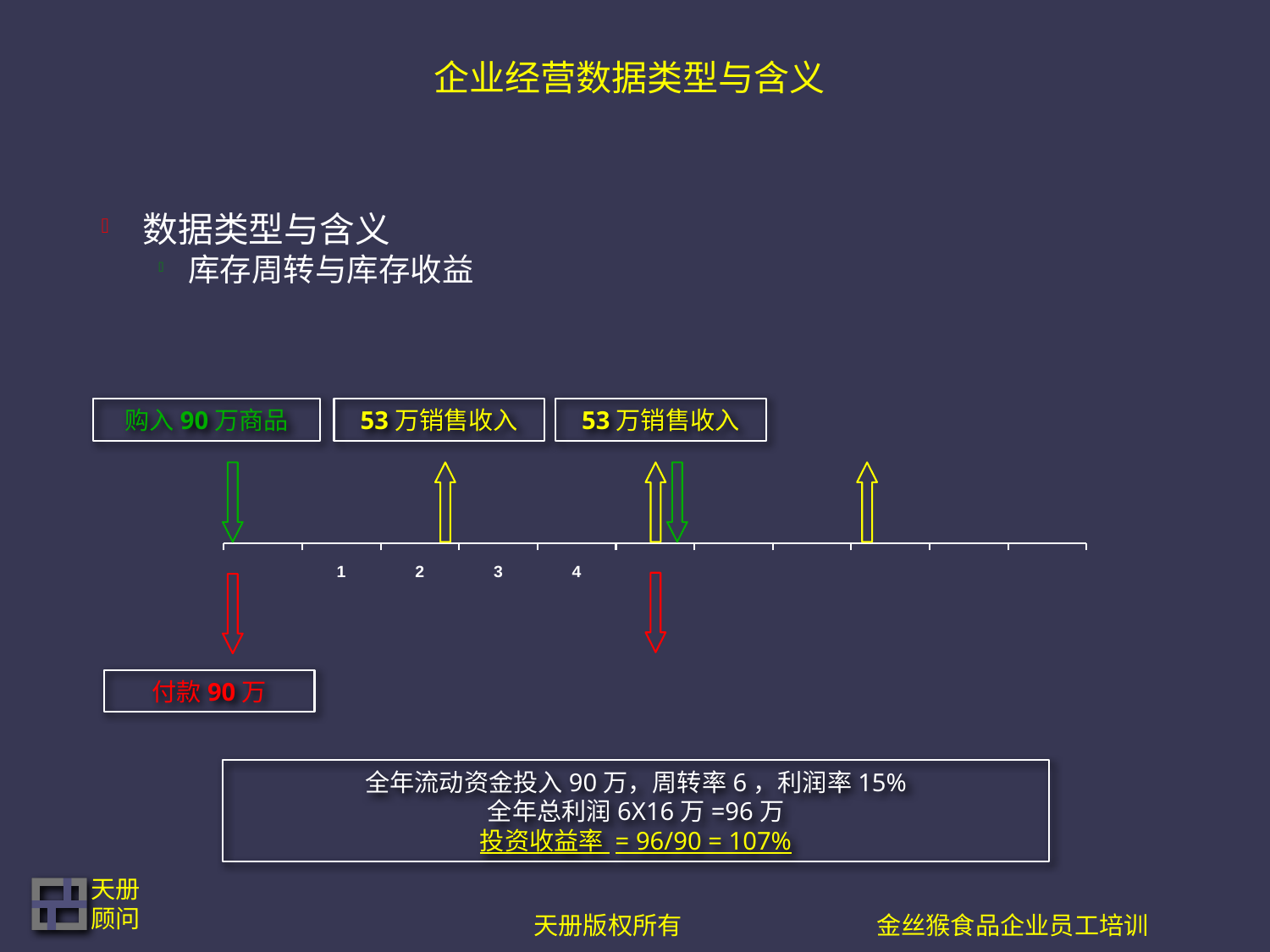
What investment return rate (投资收益率) is stated in the box below the diagram? 107% How many yellow '53 万销售收入' labels appear above the timeline? 2 On the timeline diagram, what amount of goods is purchased according to the green label at the start? 90 万 What turnover rate (周转率) is stated in the summary box below the diagram? 6 How many numbered tick labels are printed along the timeline axis? 4 What colour are the downward arrows below the timeline axis? Red On the timeline diagram, what is the sales revenue shown in each yellow label? 53 万 What total annual profit (全年总利润) is stated in the summary box? 96 万 On the timeline diagram, what payment amount is shown in the red label below the axis? 90 万